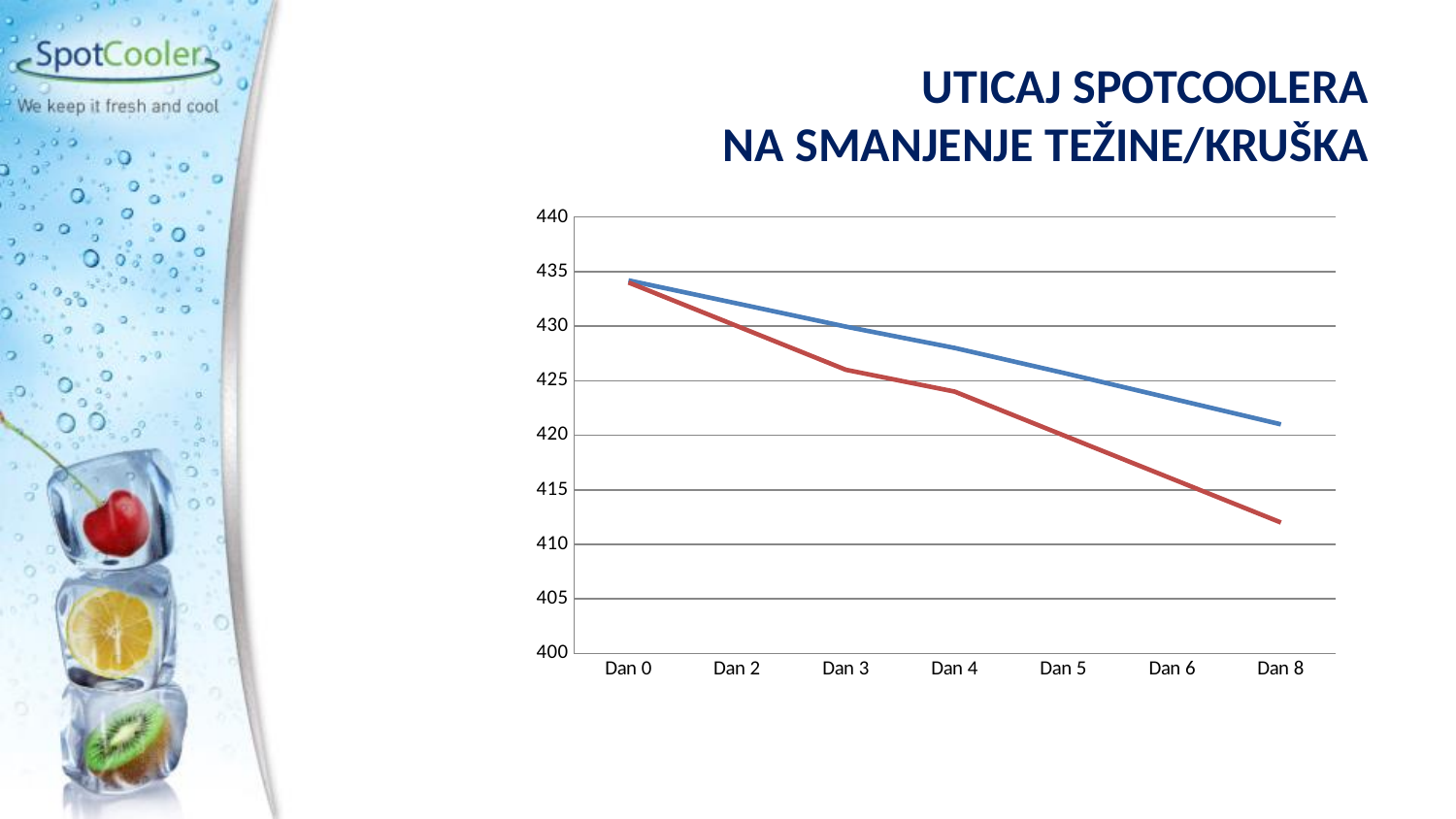
Do the values of the blue line rise or fall from Dan 0 to Dan 8? fall What is the title of the chart on the slide? UTICAJ SPOTCOOLERA NA SMANJENJE TEŽINE/KRUŠKA Is the value of the blue line at Dan 8 greater or less than 425? less How many lines are plotted on the chart? 2 Do the values of the red line rise or fall from Dan 0 to Dan 8? fall At Dan 8, which line has the higher value, the blue line or the red line? the blue line Is the value of the blue line at Dan 4 greater or less than 425? greater Is the value of the red line at Dan 8 greater or less than 415? less How many points are there along the x axis of the chart? 7 What kind of chart is shown on the slide? line chart Which line ends at the lowest value at Dan 8? the red line